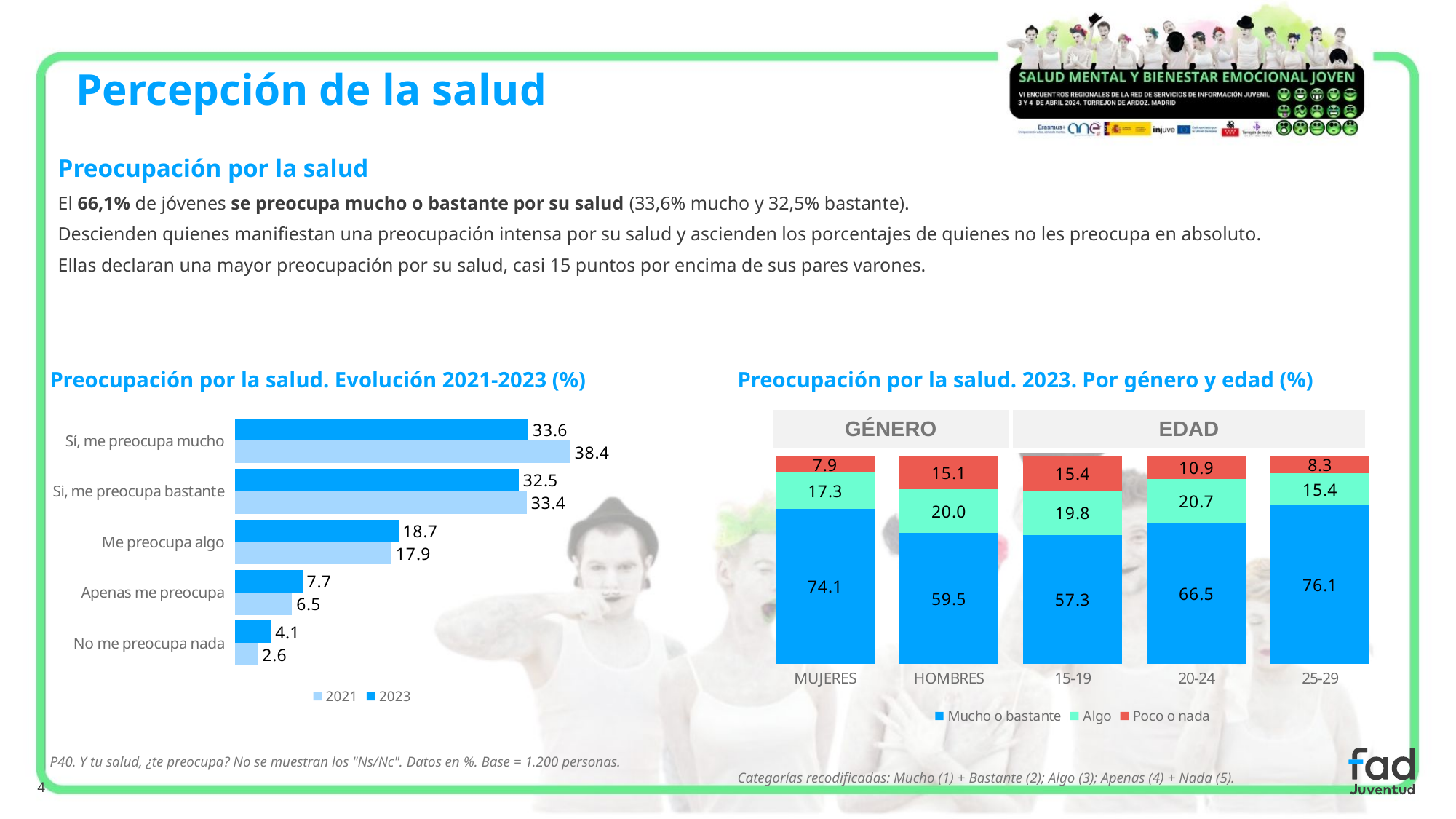
In the chart 'Preocupación por la salud. Evolución 2021-2023 (%)', what is the 2023 value for 'Sí, me preocupa mucho'? 33.6 In the chart 'Preocupación por la salud. 2023. Por género y edad (%)', what is the 'Poco o nada' value for 15-19? 15.4 In the chart 'Preocupación por la salud. 2023. Por género y edad (%)', what is the 'Mucho o bastante' value for MUJERES? 74.1 In the chart 'Preocupación por la salud. 2023. Por género y edad (%)', which group has the highest 'Mucho o bastante' value? 25-29 In the chart 'Preocupación por la salud. Evolución 2021-2023 (%)', which category has the highest 2021 value? Sí, me preocupa mucho In the chart 'Preocupación por la salud. Evolución 2021-2023 (%)', what is the difference between the 2021 and 2023 values for 'Sí, me preocupa mucho'? 4.8 In the chart 'Preocupación por la salud. 2023. Por género y edad (%)', what is the total of the stacked bar for HOMBRES? 94.6 What kind of chart is 'Preocupación por la salud. Evolución 2021-2023 (%)'? Bar chart In the chart 'Preocupación por la salud. Evolución 2021-2023 (%)', how many categories are shown? 5 In the chart 'Preocupación por la salud. Evolución 2021-2023 (%)', how many series does the legend list? 2 In the chart 'Preocupación por la salud. Evolución 2021-2023 (%)', what is the 2021 value for 'No me preocupa nada'? 2.6 In the chart 'Preocupación por la salud. 2023. Por género y edad (%)', which is larger: the 'Algo' value for 20-24 or for 25-29? 20-24